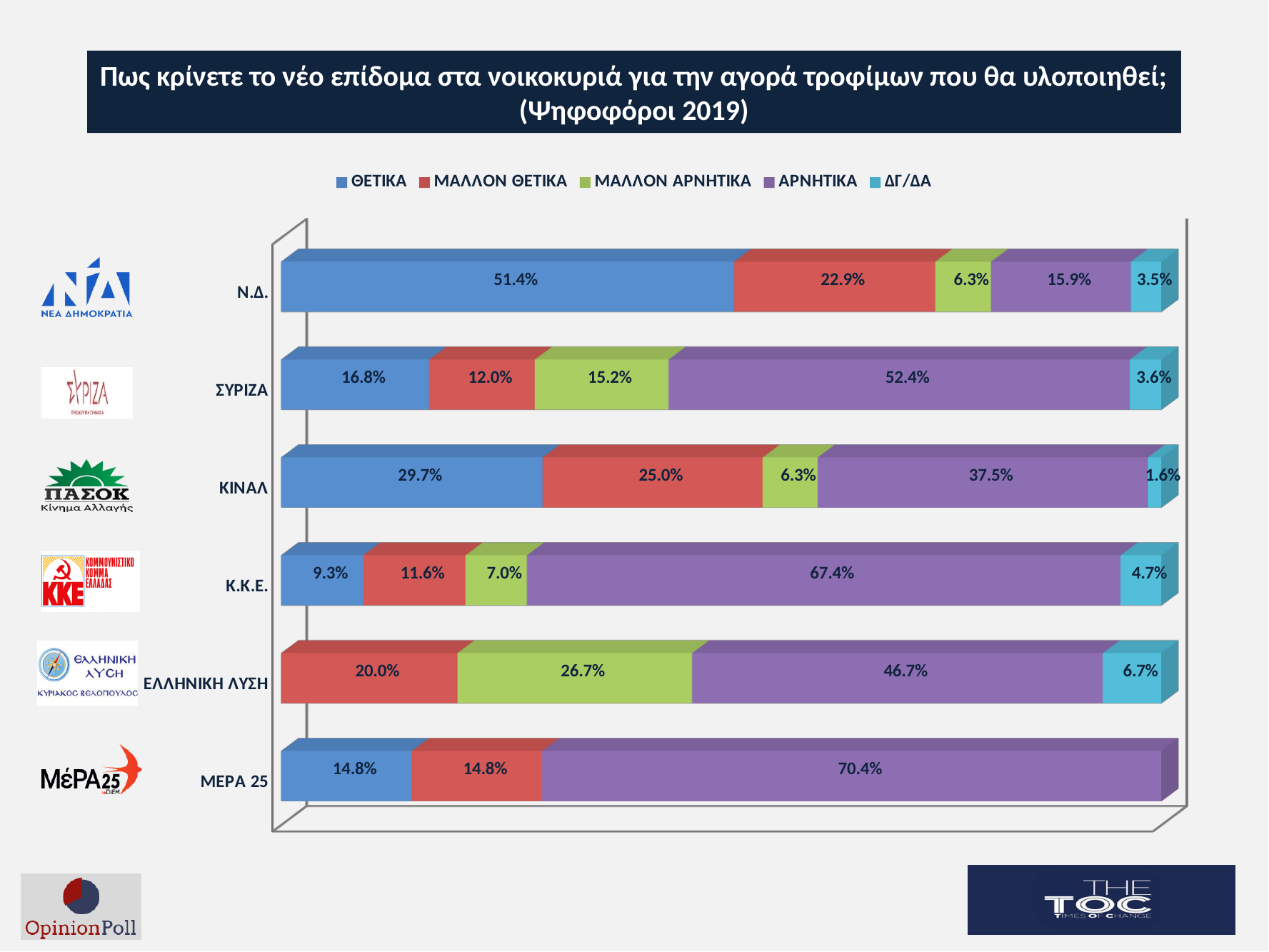
Which party has the highest ΑΡΝΗΤΙΚΑ value? ΜΕΡΑ 25 What is the ΑΡΝΗΤΙΚΑ value for Κ.Κ.Ε.? 67.4% What is the ΜΑΛΛΟΝ ΑΡΝΗΤΙΚΑ value for ΕΛΛΗΝΙΚΗ ΛΥΣΗ? 26.7% What kind of chart is shown on the slide? Stacked bar chart Which is larger: the ΜΑΛΛΟΝ ΘΕΤΙΚΑ value for ΚΙΝΑΛ or for Ν.Δ.? ΚΙΝΑΛ How many parties are shown in the chart? 6 What percentage of Ν.Δ. voters answered ΘΕΤΙΚΑ? 51.4% How many series does the legend list? 5 Which party has the lowest ΔΓ/ΔΑ value among those with a ΔΓ/ΔΑ label? ΚΙΝΑΛ What is the difference between the ΑΡΝΗΤΙΚΑ values for ΣΥΡΙΖΑ and ΚΙΝΑΛ? 14.9% Which colour represents ΑΡΝΗΤΙΚΑ in the chart? Purple Which party has the highest ΘΕΤΙΚΑ value? Ν.Δ.